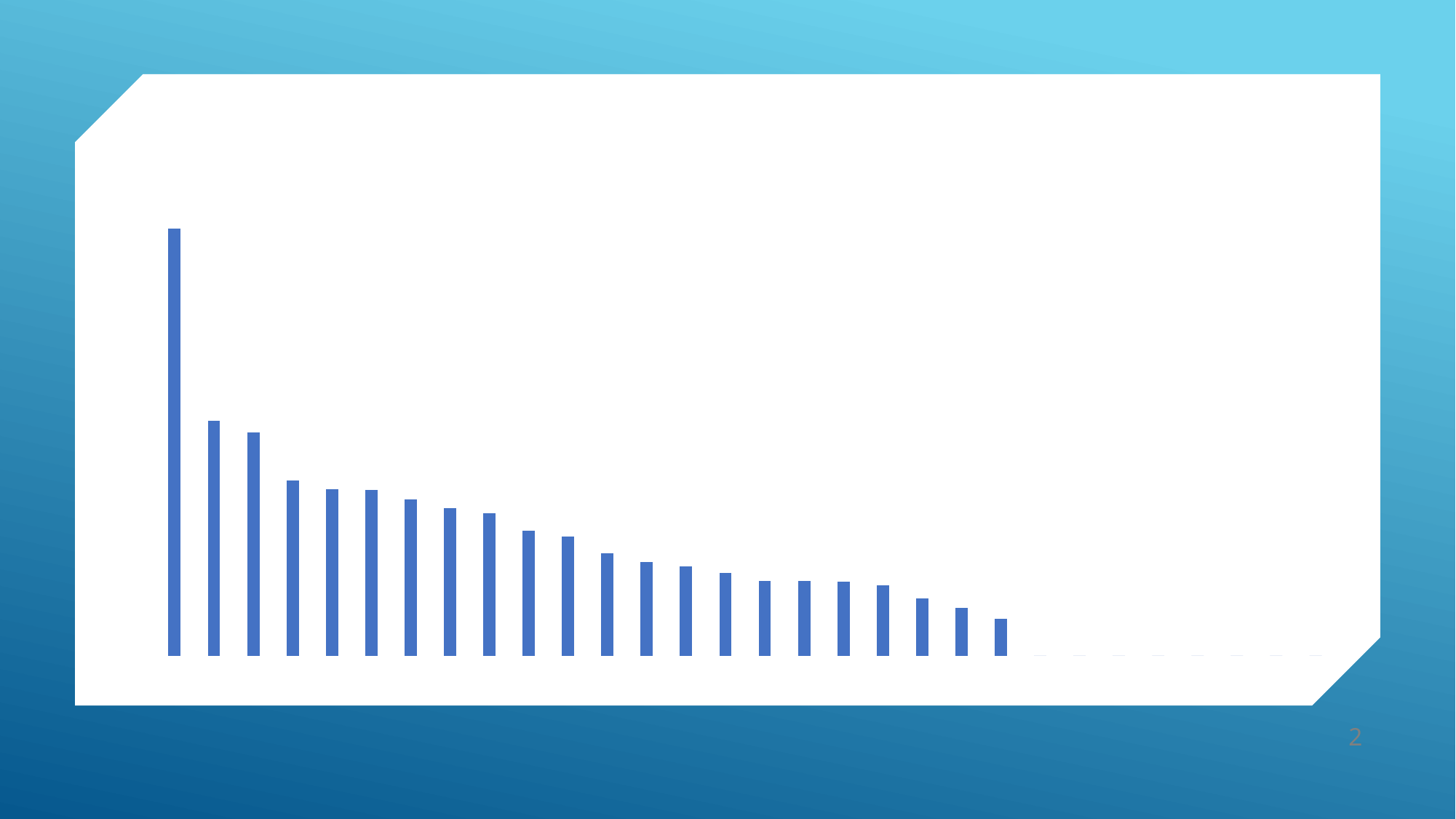
Is the leftmost bar taller or shorter than the second bar from the left? taller Which bar in the chart is the tallest? the leftmost bar Do the bar values rise or fall from left to right across the chart? fall What kind of chart is shown on the slide? bar chart What colour are the bars in the chart? blue